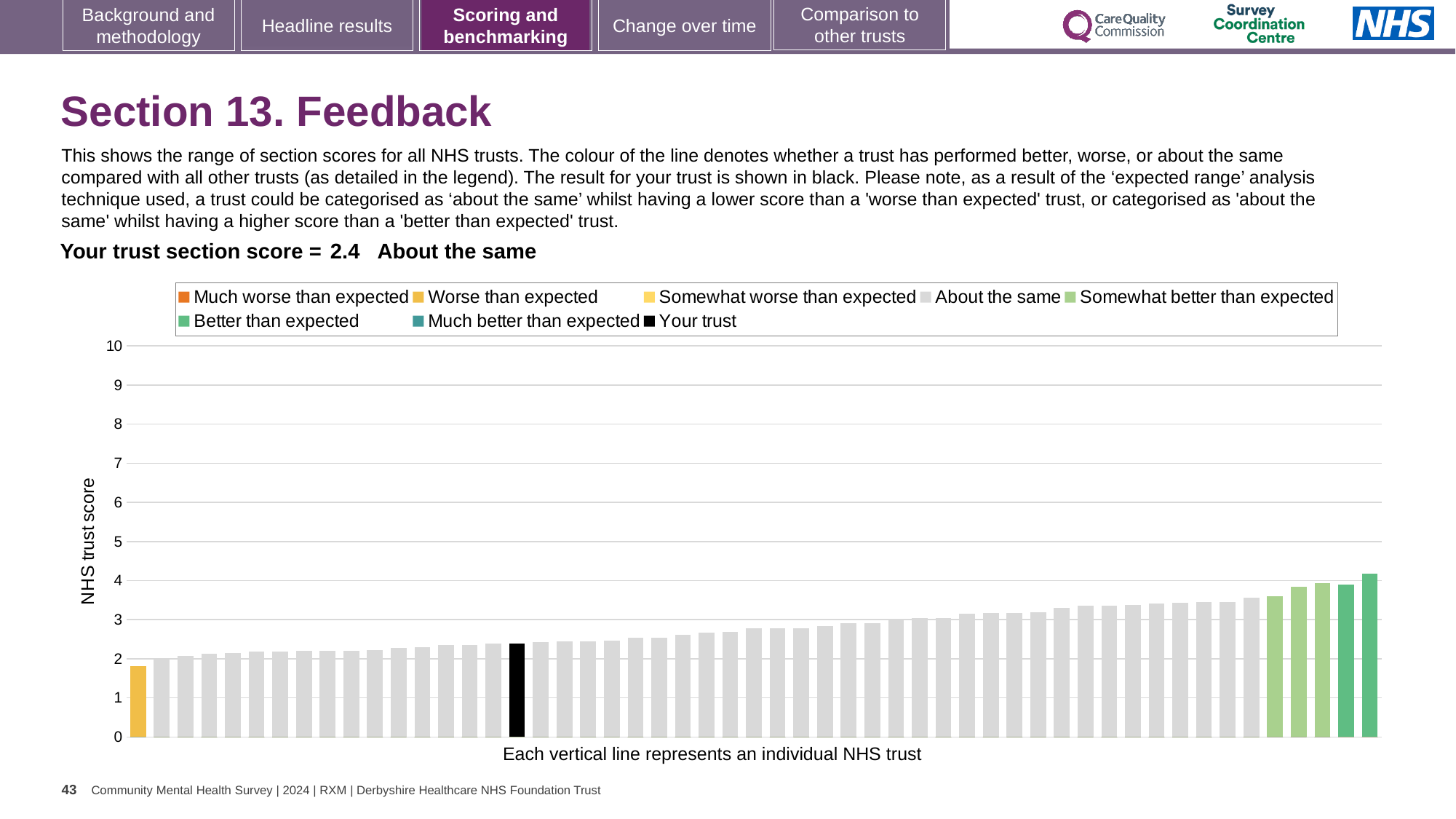
Do the bar values rise or fall from left to right along the x axis? rise How many entries does the chart legend list? 8 What is the label on the vertical axis of the chart? NHS trust score What is the section score for your trust shown on the slide? 2.4 Is the value of the black 'Your trust' bar greater or less than 3? less Is the value of the black 'Your trust' bar greater or less than 2? greater Is the value of the rightmost (highest) bar greater or less than 5? less What type of chart is shown on the slide? bar chart What colour is used for the 'Your trust' bar in the chart? black How is your trust categorised compared with other trusts for Section 13. Feedback? About the same What is the highest value shown on the vertical axis? 10